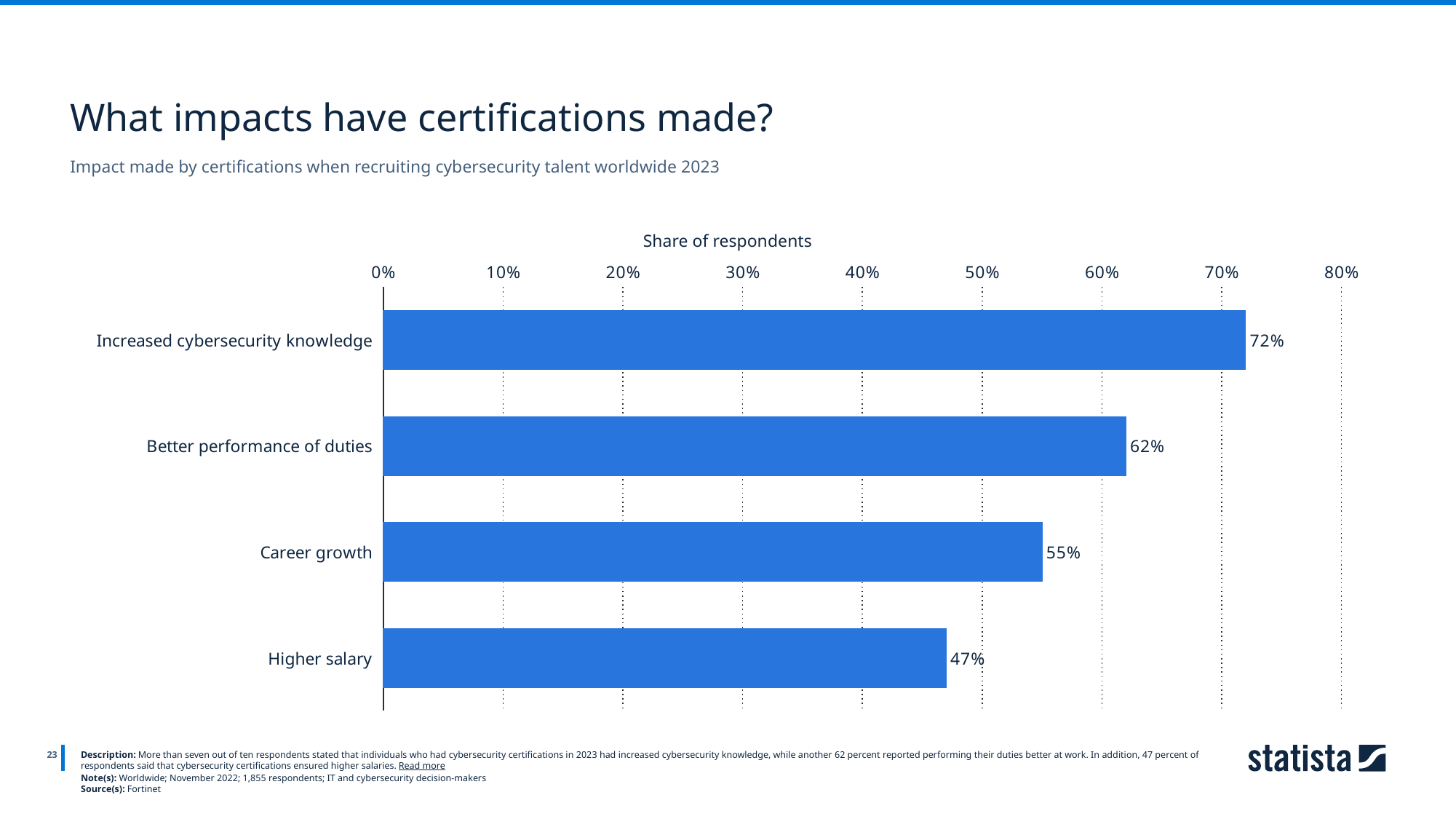
What is the label of the horizontal axis? Share of respondents Which is larger, the value for Career growth or the value for Higher salary? Career growth Which category has the lowest share of respondents? Higher salary What is the difference between the values for Increased cybersecurity knowledge and Higher salary? 25% What kind of chart is shown on the slide? Bar chart What share of respondents reported increased cybersecurity knowledge as an impact of certifications? 72% What is the value for Better performance of duties? 62% What is the difference between Better performance of duties and Career growth? 7% What share of respondents cited Career growth? 55% What is the value for Higher salary? 47% Which category has the highest share of respondents? Increased cybersecurity knowledge How many categories are shown in the chart? 4